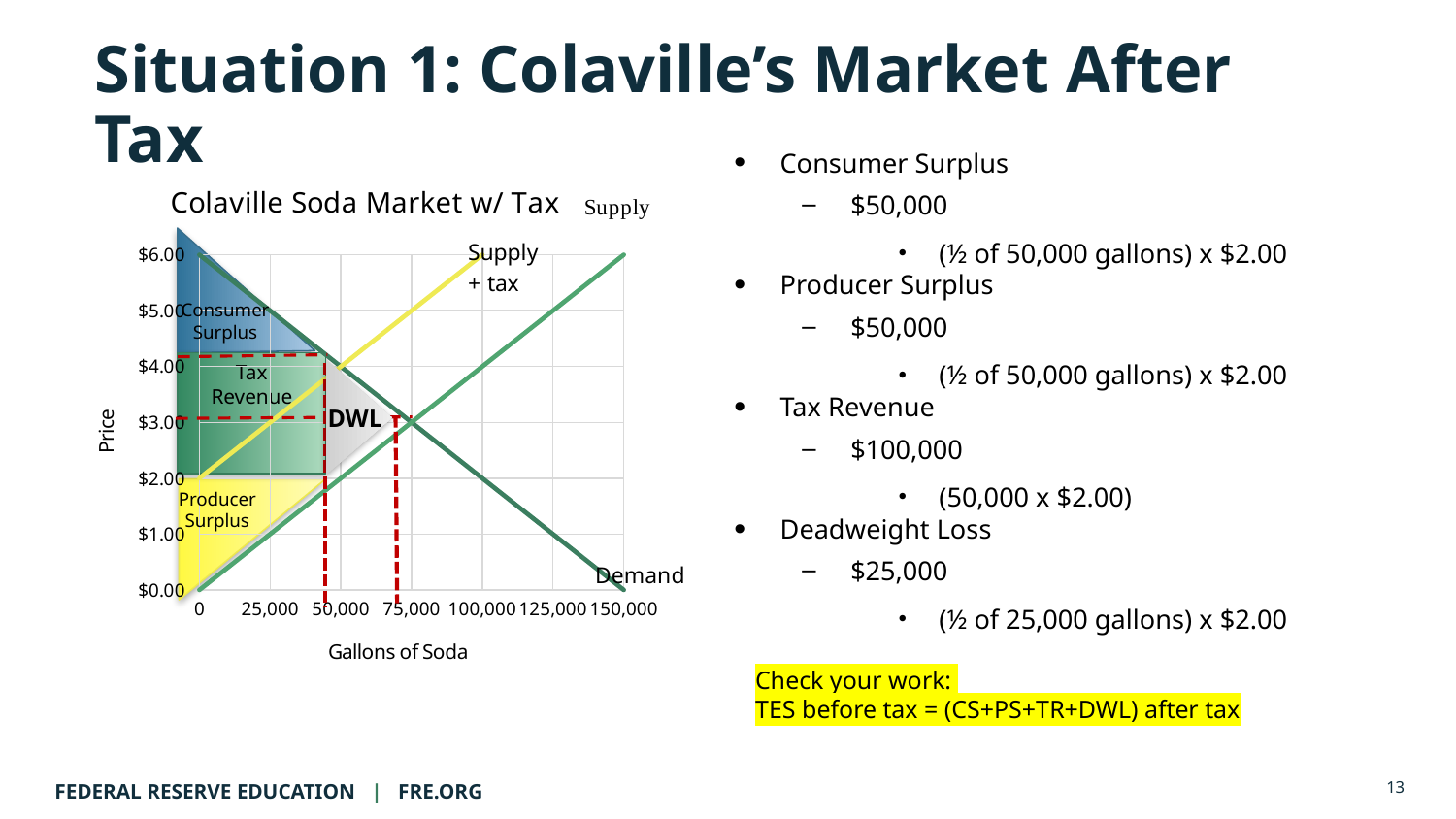
What is the highest price shown on the y axis of the chart? $6.00 Does the Supply line rise or fall as gallons of soda increase? rise At what quantity of gallons does the Supply + tax line intersect the Demand line, as marked by the dashed line? 50,000 What is the largest quantity tick shown on the x axis of the chart? 150,000 How many lines are plotted on the chart (Supply, Supply + tax, Demand)? 3 What is the label of the x axis of the chart? Gallons of Soda What kind of chart is shown on the slide? line chart At what quantity of gallons does the original Supply line intersect the Demand line, as marked by the dashed line? 75,000 Does the Demand line rise or fall as gallons of soda increase? fall What is the title of the chart? Colaville Soda Market w/ Tax At what price does the original Supply line intersect the Demand line? $3.00 Is the quantity where Supply + tax meets Demand greater or less than 75,000 gallons? less